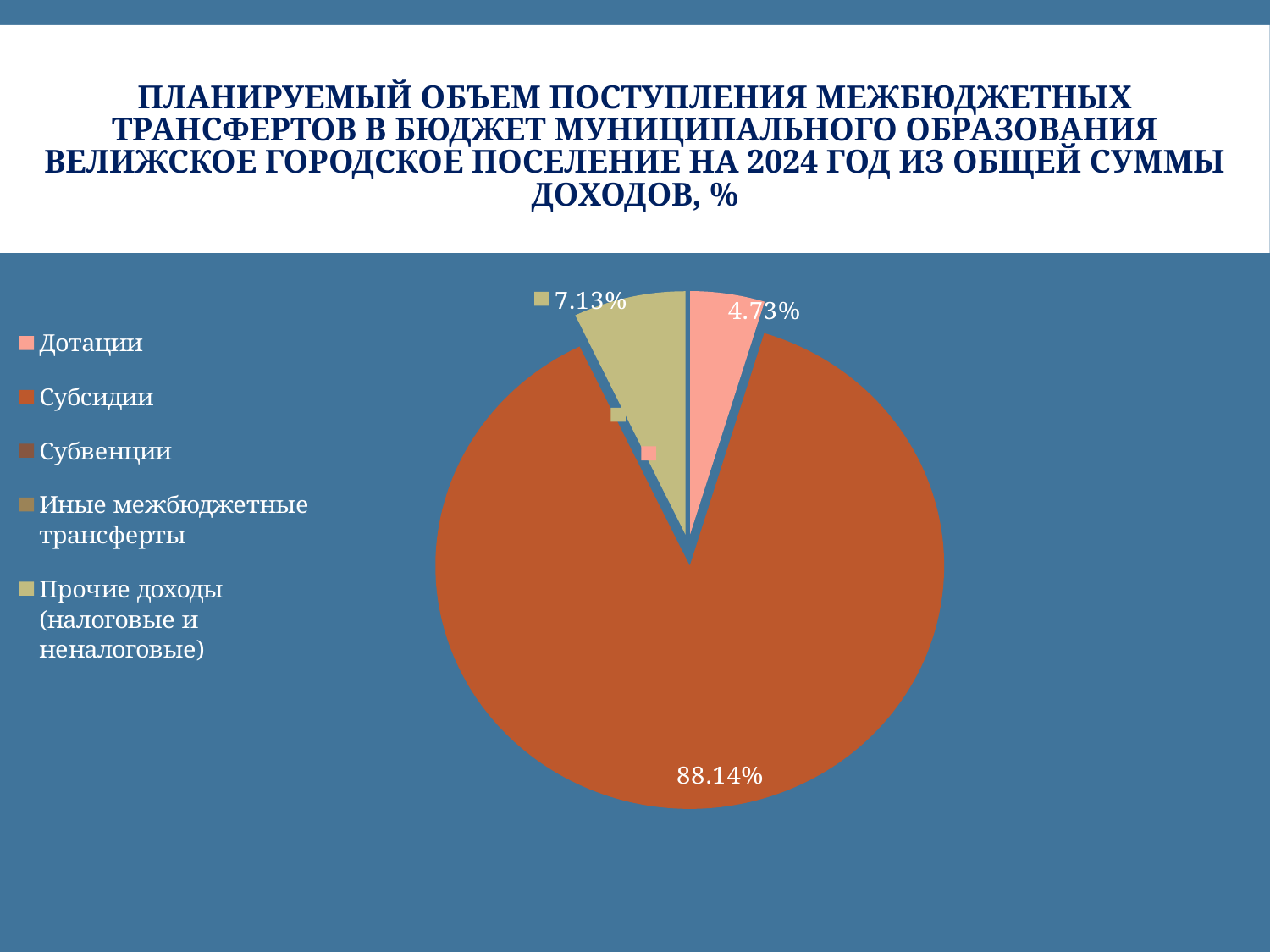
What colour is the Субсидии slice? orange-red How many categories does the legend list? 5 What share of the pie does Субсидии account for? 88.14% Which is larger: the slice for Прочие доходы (налоговые и неналоговые) or the slice for Дотации? Прочие доходы (налоговые и неналоговые) What kind of chart is shown on the slide? pie chart Which category has the largest slice of the pie? Субсидии What is the difference in percentage points between the Прочие доходы (налоговые и неналоговые) slice and the Дотации slice? 2.40 Which year does the chart title refer to? 2024 What is the difference in percentage points between the Субсидии slice and the Дотации slice? 83.41 What share of the pie does Прочие доходы (налоговые и неналоговые) account for? 7.13% What share of the pie does Дотации account for? 4.73%